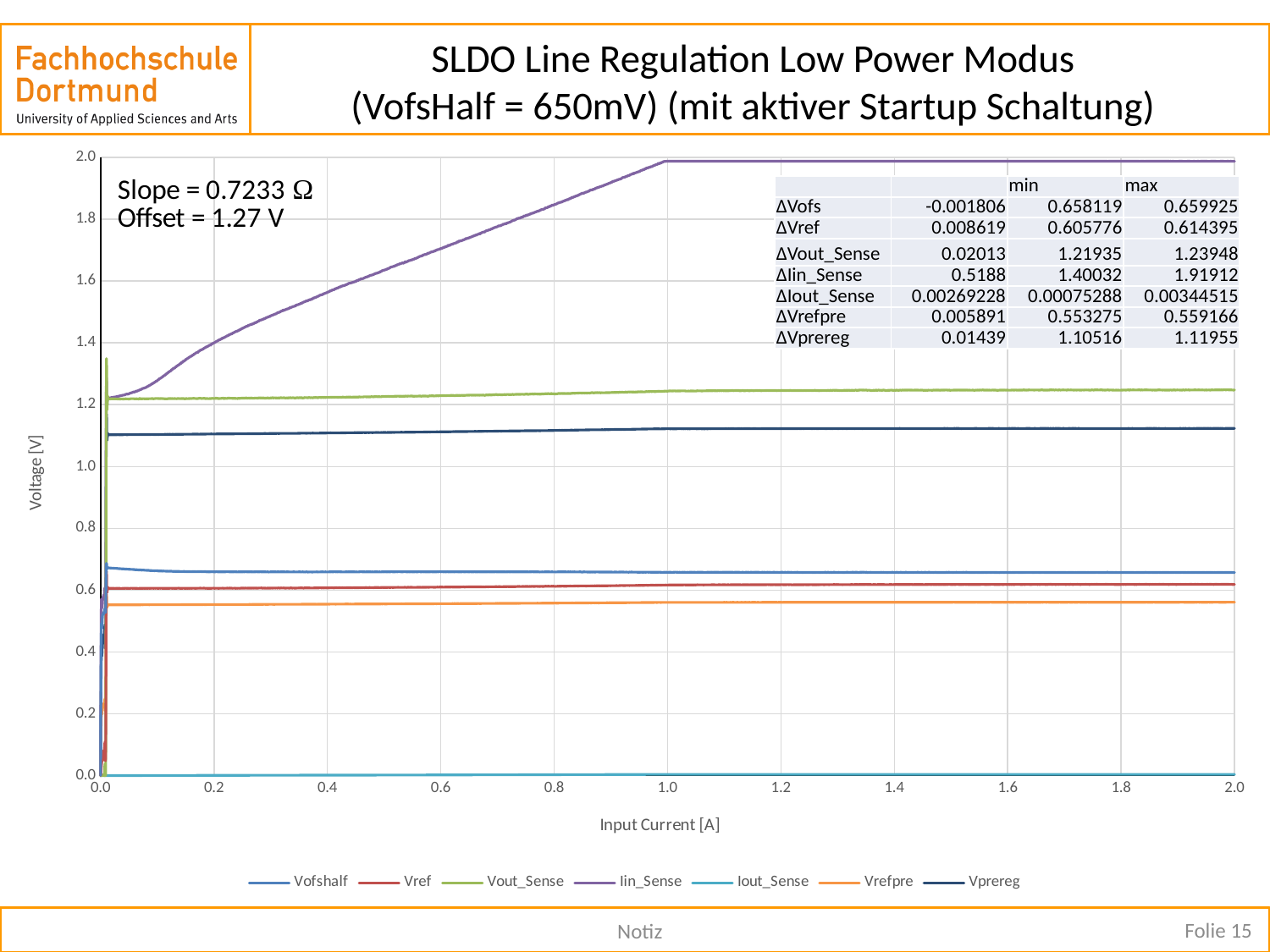
At an input current of 1.0 A, which is larger: Vofshalf or Vref? Vofshalf What is the title of the x axis? Input Current [A] How many series does the legend list? 7 Is the value of Vprereg at an input current of 1.0 A greater or less than 1.2? less Is the value of Vout_Sense at an input current of 2.0 A greater or less than 1.0? greater Does the Iin_Sense series rise or fall as the input current increases from 0.0 A to 1.0 A? rise Is the value of Iin_Sense at an input current of 0.4 A greater or less than 1.4? greater Which series are listed in the legend? Vofshalf, Vref, Vout_Sense, Iin_Sense, Iout_Sense, Vrefpre, Vprereg Which series has the highest value at an input current of 2.0 A? Iin_Sense At an input current of 1.5 A, which is larger: Vprereg or Vrefpre? Vprereg What kind of chart is shown on the slide? line chart